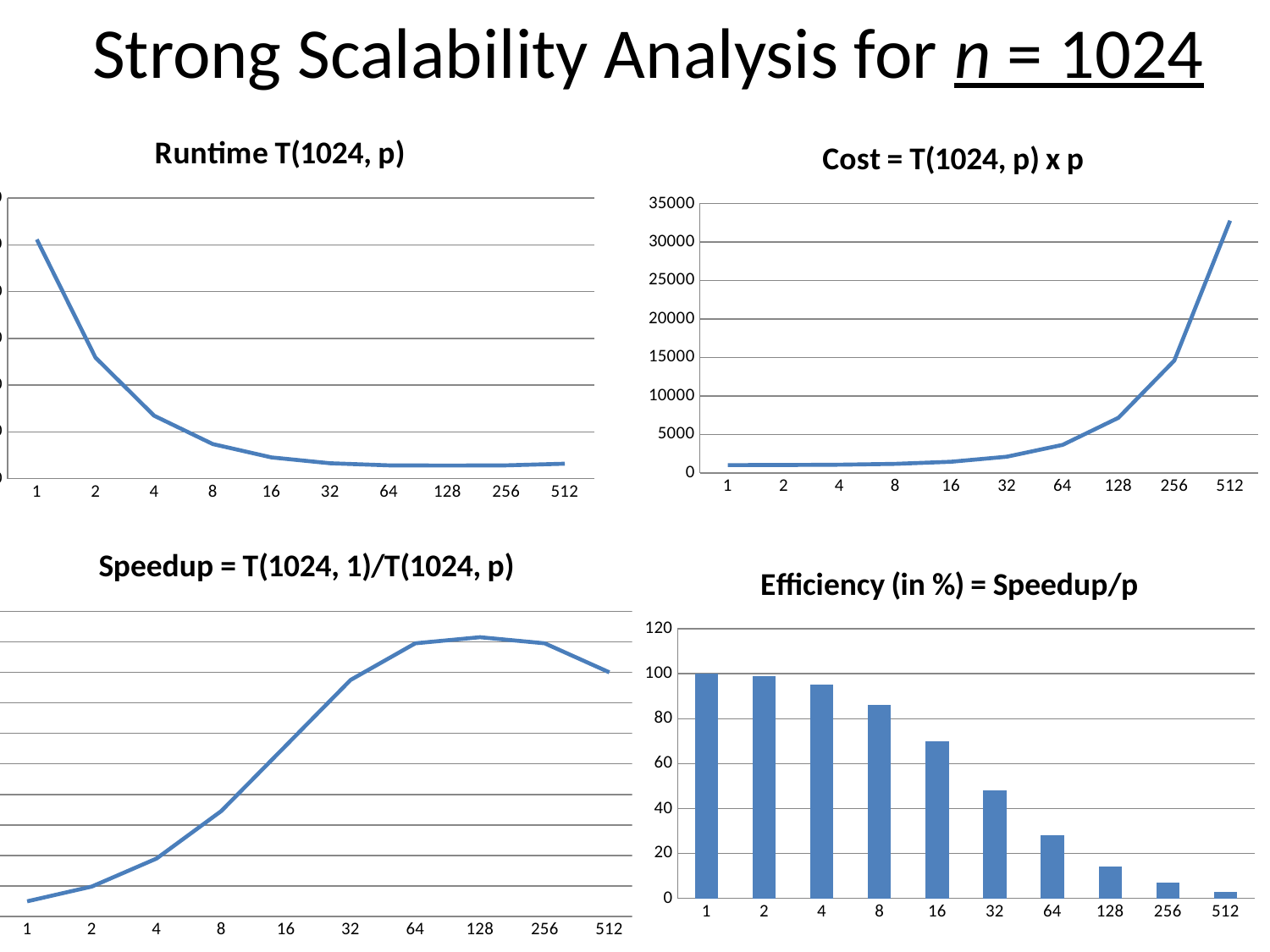
In the Speedup = T(1024, 1)/T(1024, p) chart, at which value of p does the speedup reach its peak? 128 In the Cost = T(1024, p) x p chart, is the value for p = 512 greater or less than 30000? greater In the Runtime T(1024, p) chart, do the values rise or fall as p increases from 1 to 64? fall How many values of p are plotted on the Efficiency (in %) = Speedup/p chart? 10 What kind of chart is the Efficiency (in %) = Speedup/p chart? bar chart In the Efficiency (in %) = Speedup/p chart, is the value for p = 64 greater or less than 40? less What kind of chart is the Cost = T(1024, p) x p chart? line chart In the Efficiency (in %) = Speedup/p chart, is the value for p = 16 greater or less than 60? greater In the Efficiency (in %) = Speedup/p chart, what is the efficiency for p = 1? 100 In the Efficiency (in %) = Speedup/p chart, which value of p has the highest efficiency? 1 In the Efficiency (in %) = Speedup/p chart, which value of p has the lowest efficiency? 512